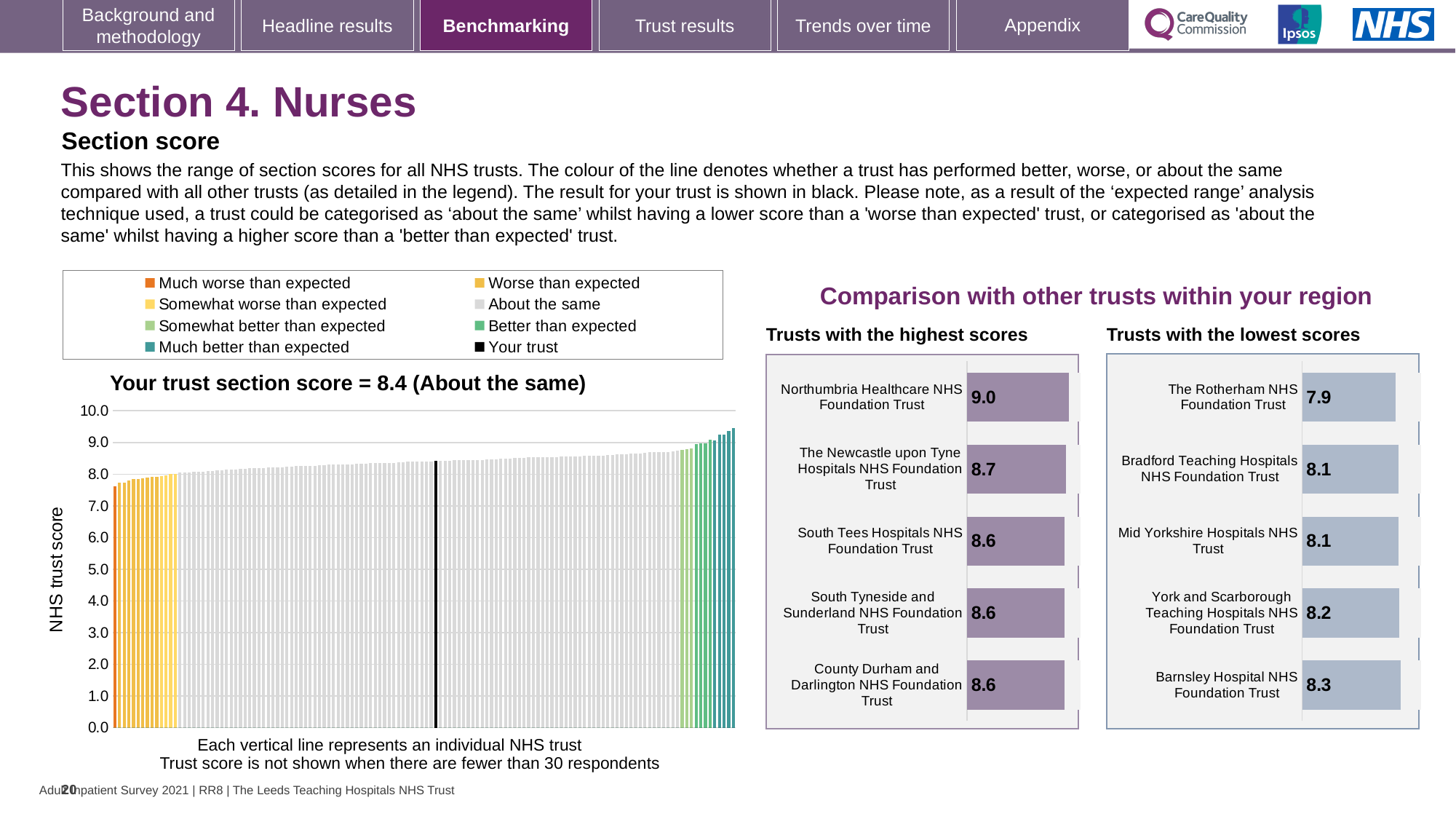
In the 'Trusts with the highest scores' chart, what is the difference between the scores of Northumbria Healthcare NHS Foundation Trust and The Newcastle upon Tyne Hospitals NHS Foundation Trust? 0.3 In the 'Trusts with the lowest scores' chart, what is the score for Bradford Teaching Hospitals NHS Foundation Trust? 8.1 What kind of chart is the 'Your trust section score' chart on the left of the slide? Bar chart In the 'Trusts with the lowest scores' chart, which has the higher score: Barnsley Hospital NHS Foundation Trust or York and Scarborough Teaching Hospitals NHS Foundation Trust? Barnsley Hospital NHS Foundation Trust According to the title of the chart on the left, what is your trust's section score? 8.4 (About the same) In the 'Trusts with the highest scores' chart, which trust has the highest score? Northumbria Healthcare NHS Foundation Trust In the 'Your trust section score' chart on the left, is the value of the leftmost (lowest) bar greater or less than 8.0? less In the 'Trusts with the highest scores' chart, what is the score for Northumbria Healthcare NHS Foundation Trust? 9.0 In the 'Your trust section score' chart on the left, do the bar values rise or fall from left to right? Rise How many trusts are listed in the 'Trusts with the highest scores' chart? 5 In the 'Trusts with the lowest scores' chart, what is the score for The Rotherham NHS Foundation Trust? 7.9 In the 'Trusts with the lowest scores' chart, which trust has the lowest score? The Rotherham NHS Foundation Trust